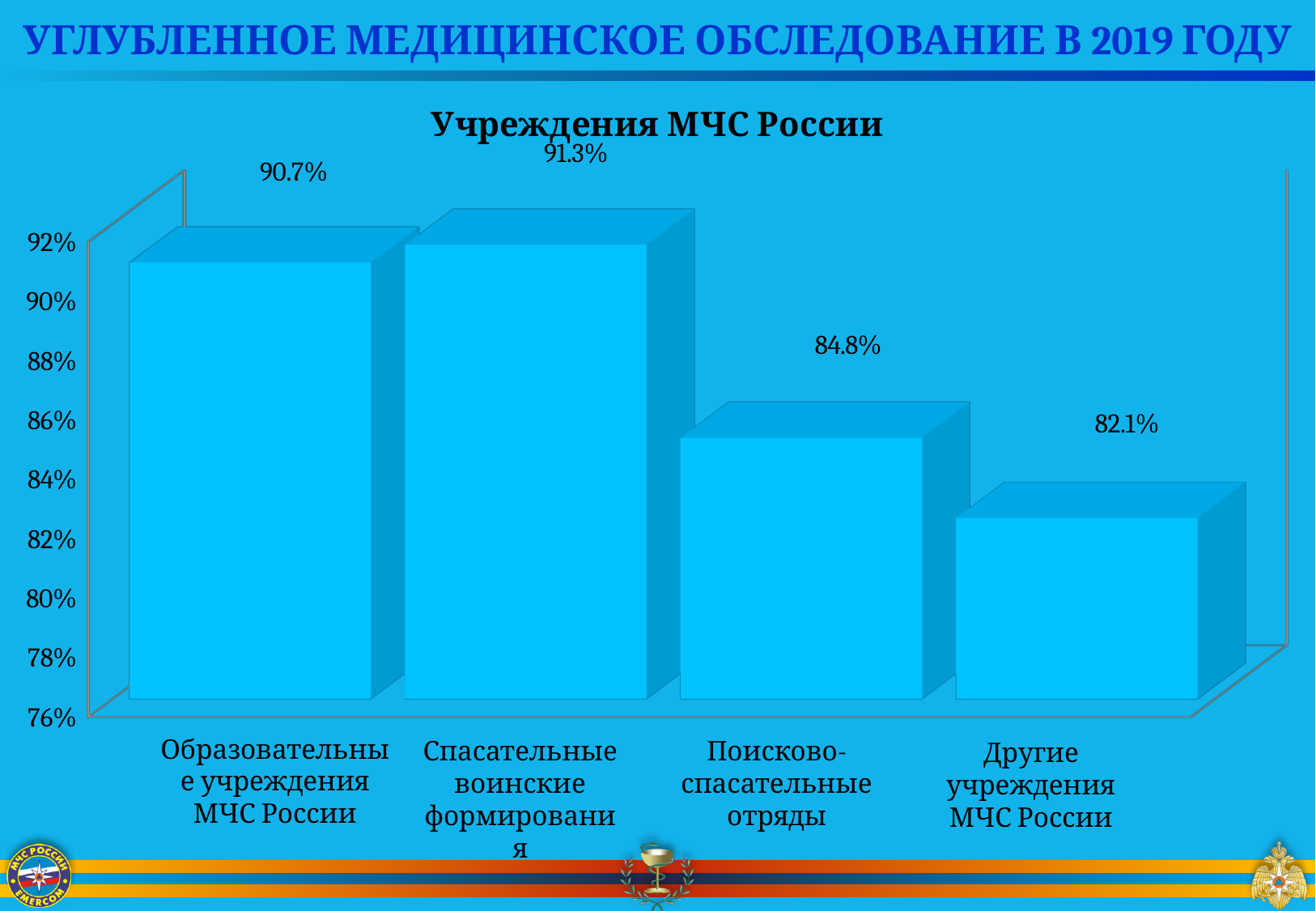
What is the difference between the values for Спасательные воинские формирования and Другие учреждения МЧС России? 9.2% How many categories are shown in the chart? 4 What is the title of the chart? Учреждения МЧС России Which is larger, the value for Поисково-спасательные отряды or the value for Другие учреждения МЧС России? Поисково-спасательные отряды What is the difference between the values for Образовательные учреждения МЧС России and Поисково-спасательные отряды? 5.9% What is the value for Поисково-спасательные отряды? 84.8% Which category has the highest value? Спасательные воинские формирования What kind of chart is shown on the slide? Bar chart Which category has the lowest value? Другие учреждения МЧС России What is the value for Спасательные воинские формирования? 91.3% What is the value for Другие учреждения МЧС России? 82.1% What is the value for Образовательные учреждения МЧС России? 90.7%